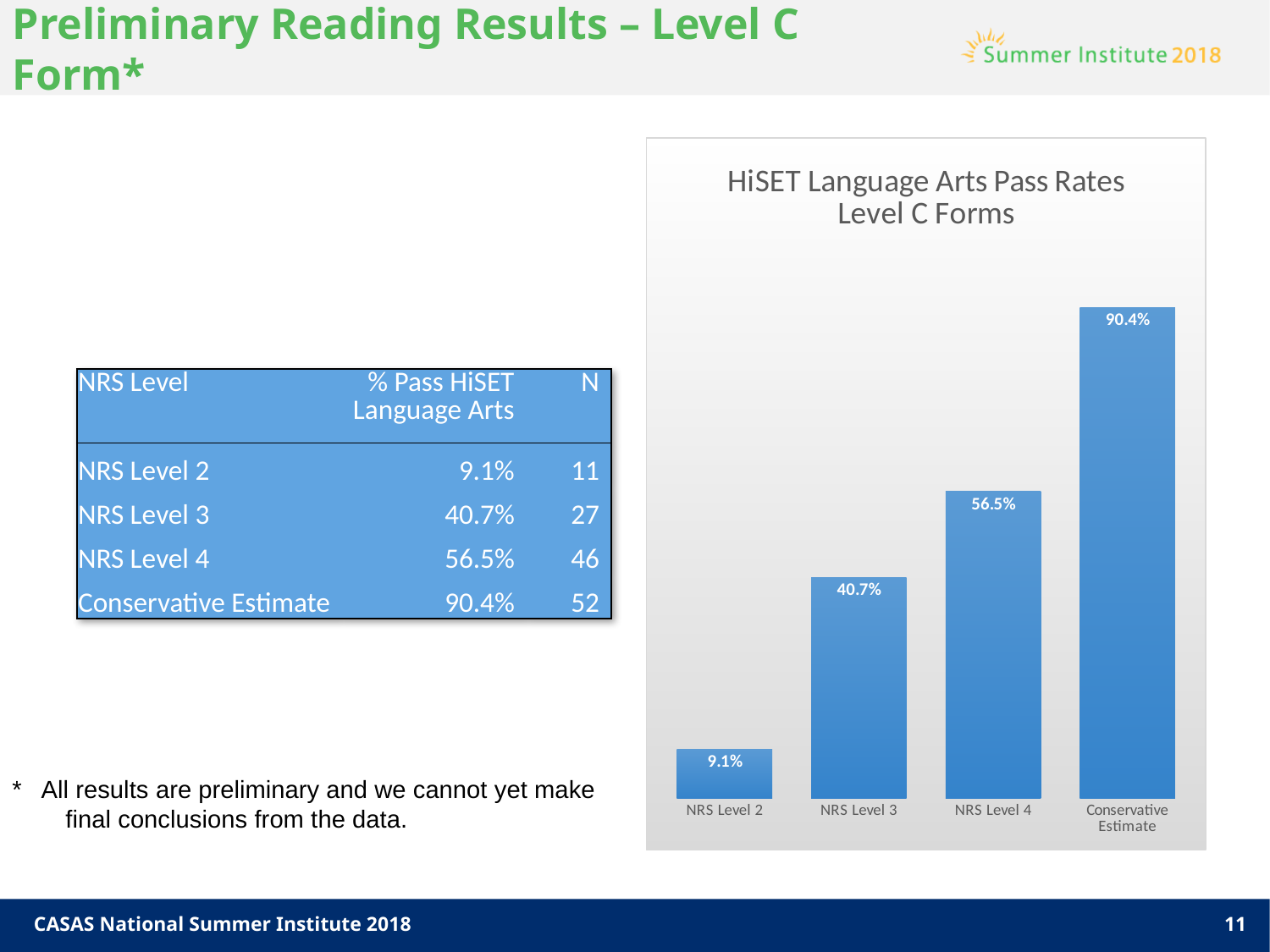
Which category has the highest pass rate in the chart? Conservative Estimate What kind of chart is shown on the slide? Bar chart Which category has the lowest pass rate in the chart? NRS Level 2 Which is larger, the pass rate for NRS Level 3 or NRS Level 4? NRS Level 4 What is the title of the chart? HiSET Language Arts Pass Rates Level C Forms What is the difference between the Conservative Estimate and the NRS Level 2 pass rate? 81.3% What is the difference between the pass rates for NRS Level 4 and NRS Level 3? 15.8% What is the pass rate shown for NRS Level 2? 9.1% What is the pass rate for NRS Level 3 in the chart? 40.7% What value is shown for the Conservative Estimate bar? 90.4% How many categories are plotted in the chart? 4 Do the pass rates rise or fall from left to right across the chart? Rise